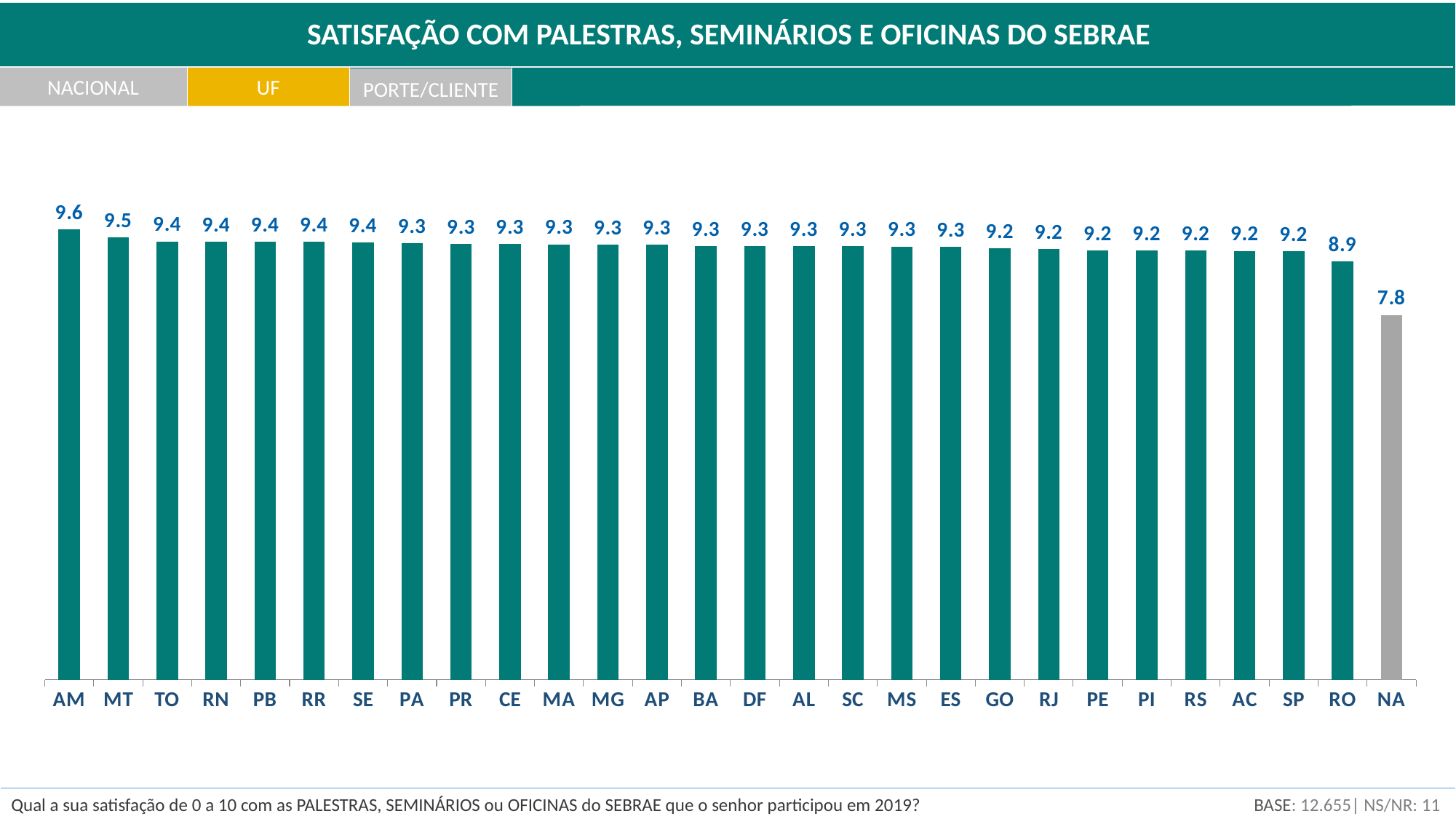
Which category has the highest value? AM What is the value shown for NA? 7.8 How many categories are shown on the x axis? 28 What is the difference between the values for MT and RO? 0.6 What is the difference between the values for AM and NA? 1.8 Which category has the lowest value? NA Which has a larger value, MT or GO? MT Do the values generally rise or fall from left to right along the x axis? Fall What is the satisfaction value for RO? 8.9 What is the satisfaction value for AM? 9.6 What is the satisfaction value for SP? 9.2 What kind of chart is shown on the slide? Bar chart